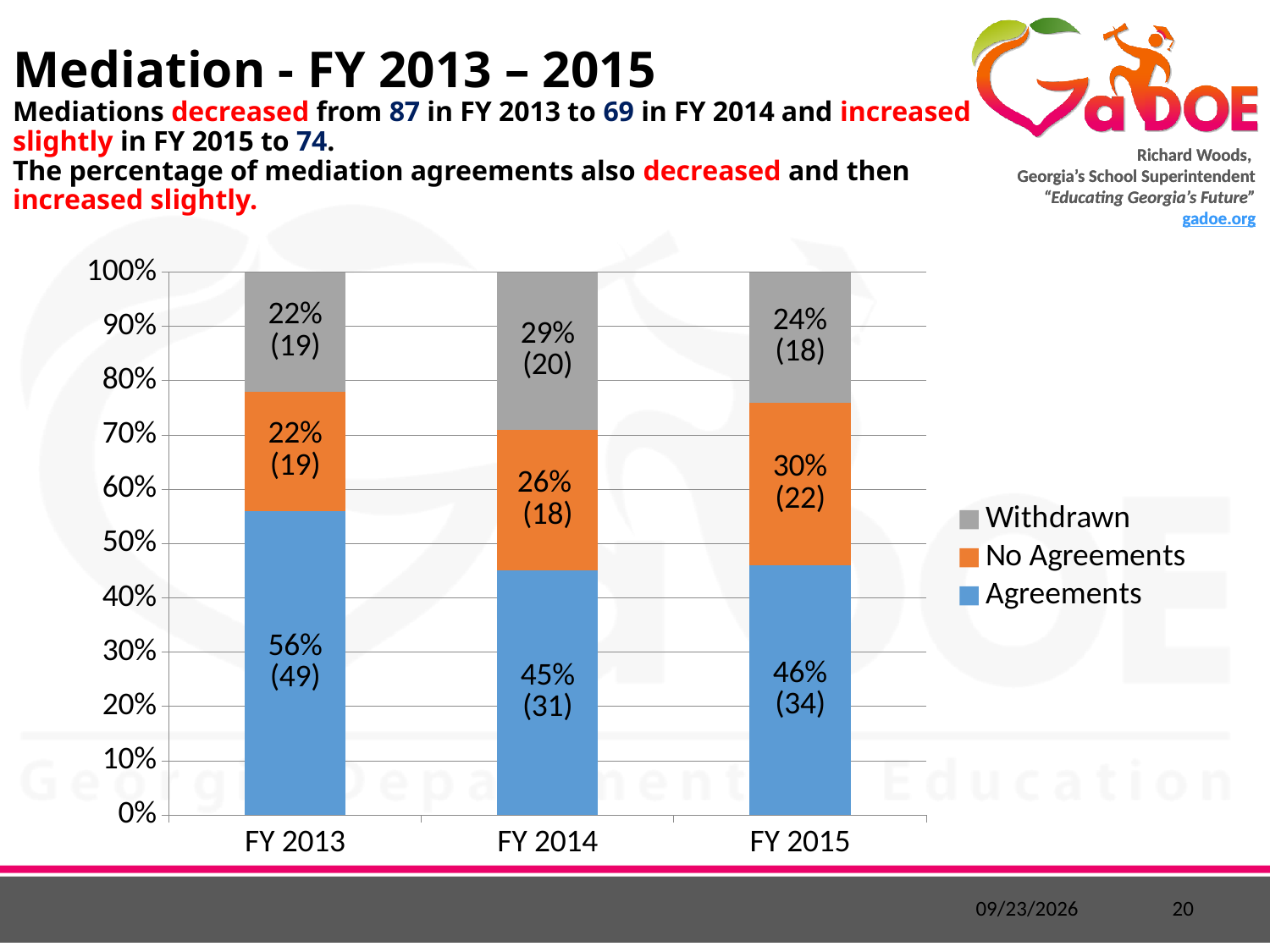
What kind of chart is shown on the slide? Stacked bar chart Which is larger: the Withdrawn percentage in FY 2014 or in FY 2015? FY 2014 How many series does the legend list? 3 Which fiscal year had the lowest percentage of Agreements? FY 2014 Which fiscal year had the highest percentage of Agreements? FY 2013 Which colour represents the Agreements series in the chart? Blue How many fiscal years are shown on the x axis? 3 What percentage of mediations in FY 2013 resulted in Agreements? 56% What is the total number of mediations in FY 2015 (sum of Agreements, No Agreements and Withdrawn)? 74 What percentage of mediations in FY 2015 were No Agreements? 30% What is the difference in the number of Agreements between FY 2013 and FY 2014? 18 How many mediations were Withdrawn in FY 2014? 20